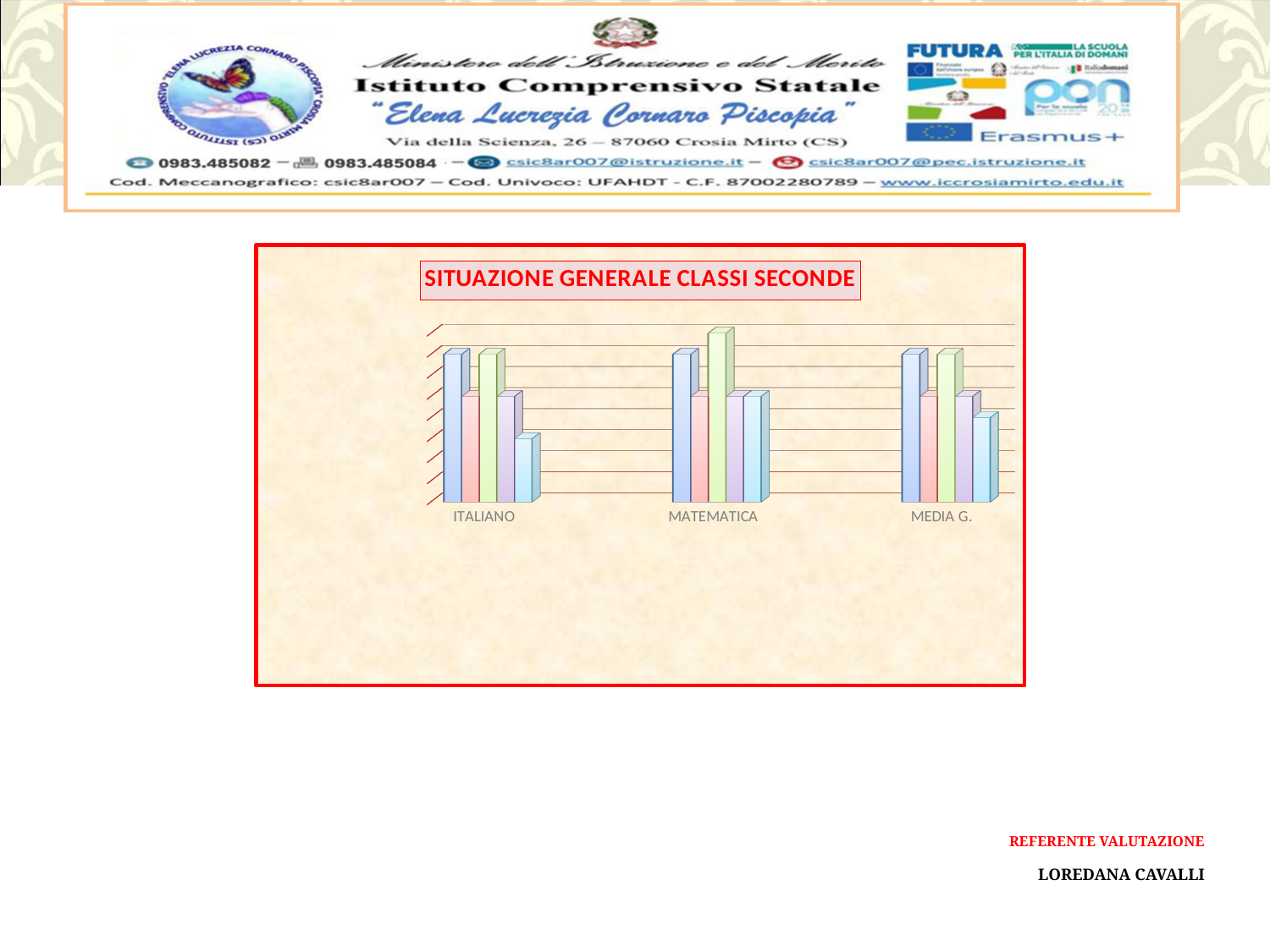
What kind of chart is shown on the slide? bar chart How many bars are plotted for each category in the chart? 5 How many categories are shown on the x axis of the chart? 3 In the MATEMATICA group, which bar is the tallest: the first (blue) bar or the third (green) bar? the third (green) bar In the ITALIANO group, which bar is taller: the first (blue) bar or the last (light blue) bar? the first (blue) bar Which category is labelled furthest to the left on the x axis? ITALIANO Which category is labelled furthest to the right on the x axis? MEDIA G. What is the title of the chart? SITUAZIONE GENERALE CLASSI SECONDE In the MEDIA G. group, which bar is shorter: the second (pink) bar or the last (light blue) bar? the last (light blue) bar Which category is labelled in the middle of the x axis? MATEMATICA